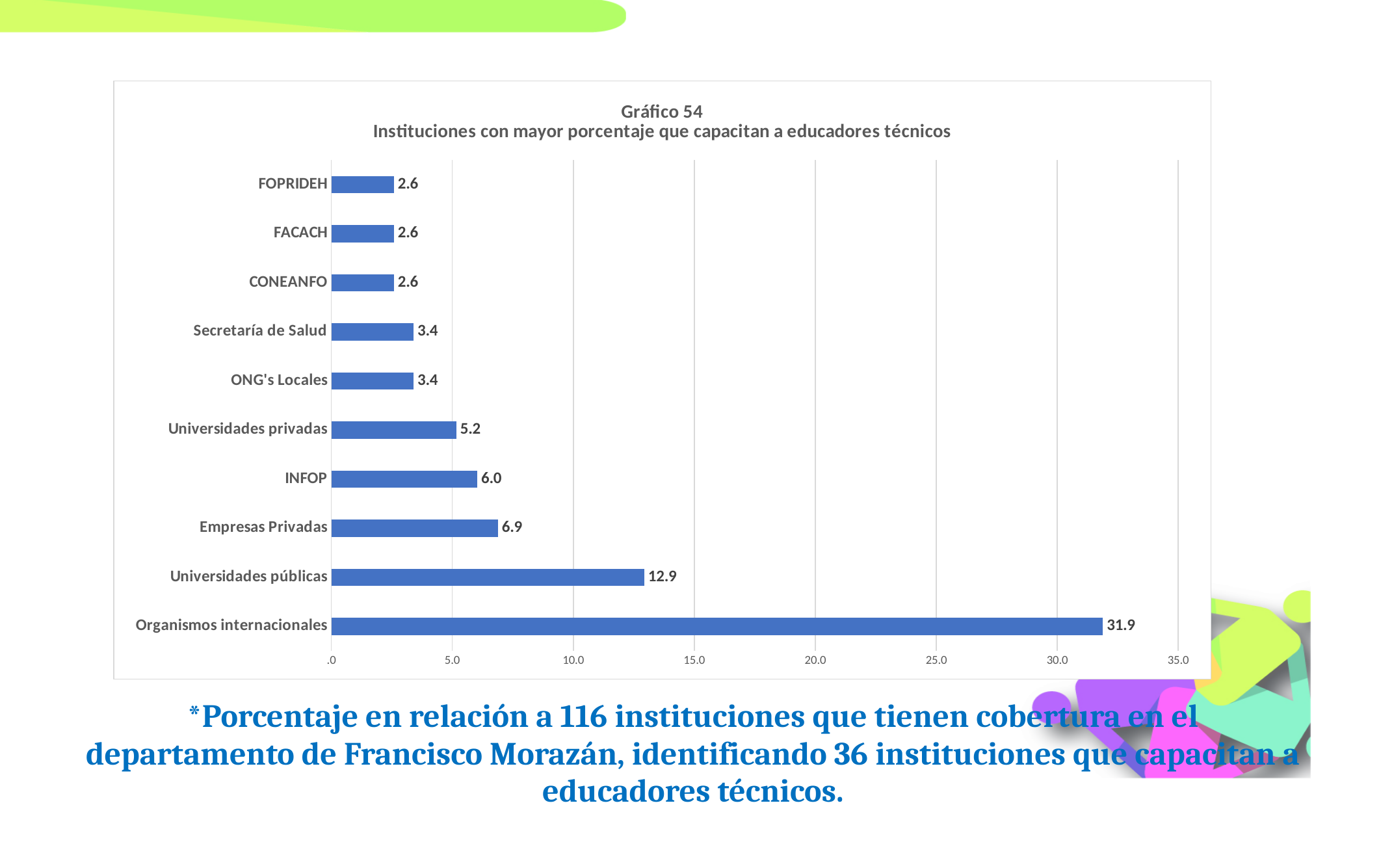
What is the difference between the values for Empresas Privadas and Universidades privadas? 1.7 Which category has the highest value? Organismos internacionales What is the value for Secretaría de Salud? 3.4 What is the value for Organismos internacionales? 31.9 What is the value for INFOP? 6.0 What kind of chart is shown on the slide? bar chart How many categories are shown in the chart? 10 What is the value for Universidades públicas? 12.9 Is the value for Universidades públicas greater or less than 10.0? greater Which is larger, the value for INFOP or the value for Universidades privadas? INFOP What is the title of the chart? Gráfico 54 Instituciones con mayor porcentaje que capacitan a educadores técnicos What is the difference between the values for Organismos internacionales and Universidades públicas? 19.0